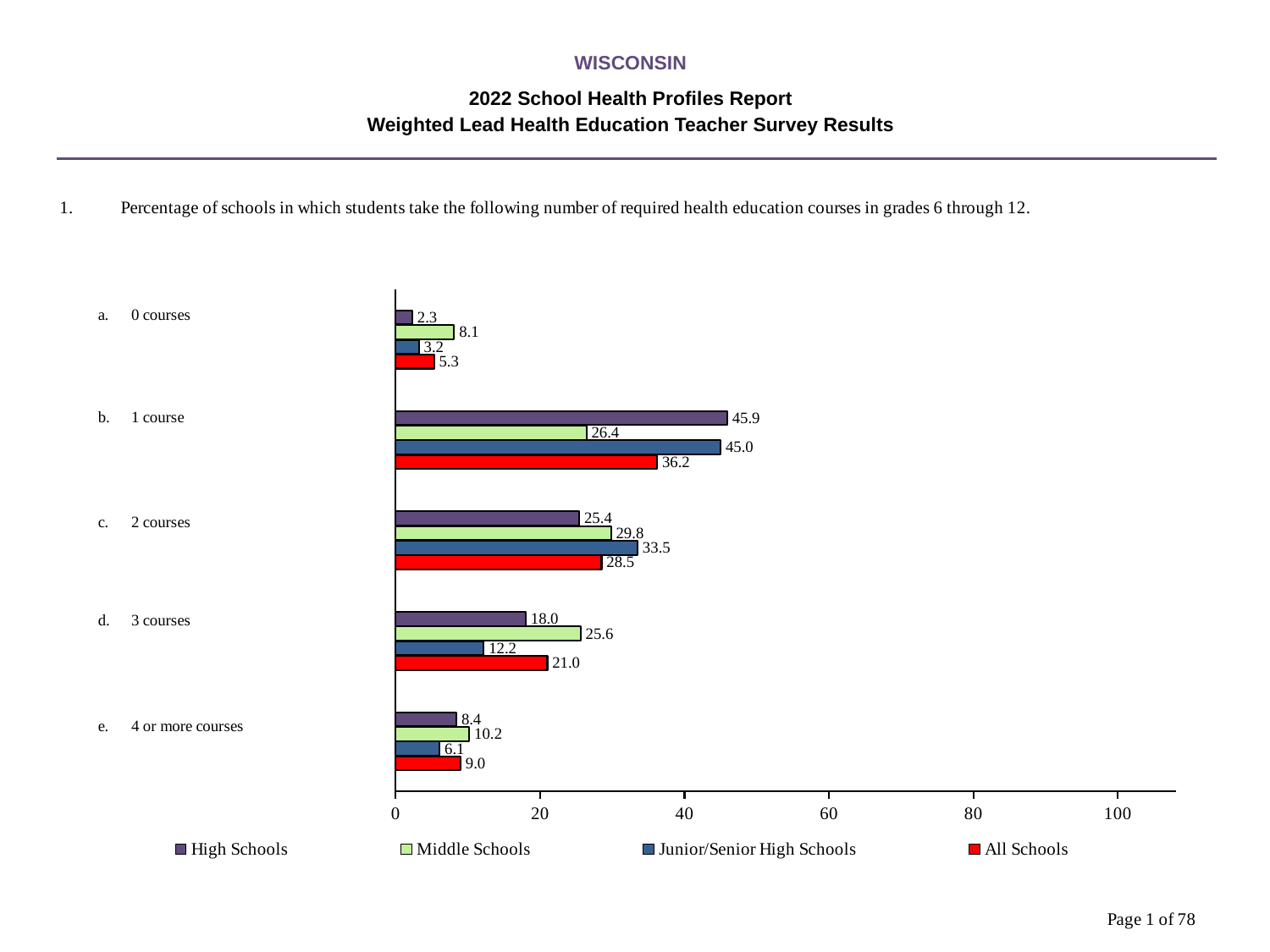
Which category has the lowest value for High Schools? 0 courses In the '2 courses' category, which is larger: the Junior/Senior High Schools value or the High Schools value? Junior/Senior High Schools How many series does the legend list? 4 What is the difference between the High Schools and Middle Schools values in the '1 course' category? 19.5 What is the value for All Schools in the '0 courses' category? 5.3 What is the value for High Schools in the '1 course' category? 45.9 How many categories are shown on the chart? 5 Which category has the highest value for All Schools? 1 course What kind of chart is shown on the slide? Bar chart Which series is shown in red in the legend? All Schools What is the value for Middle Schools in the '3 courses' category? 25.6 What is the value for Junior/Senior High Schools in the '4 or more courses' category? 6.1